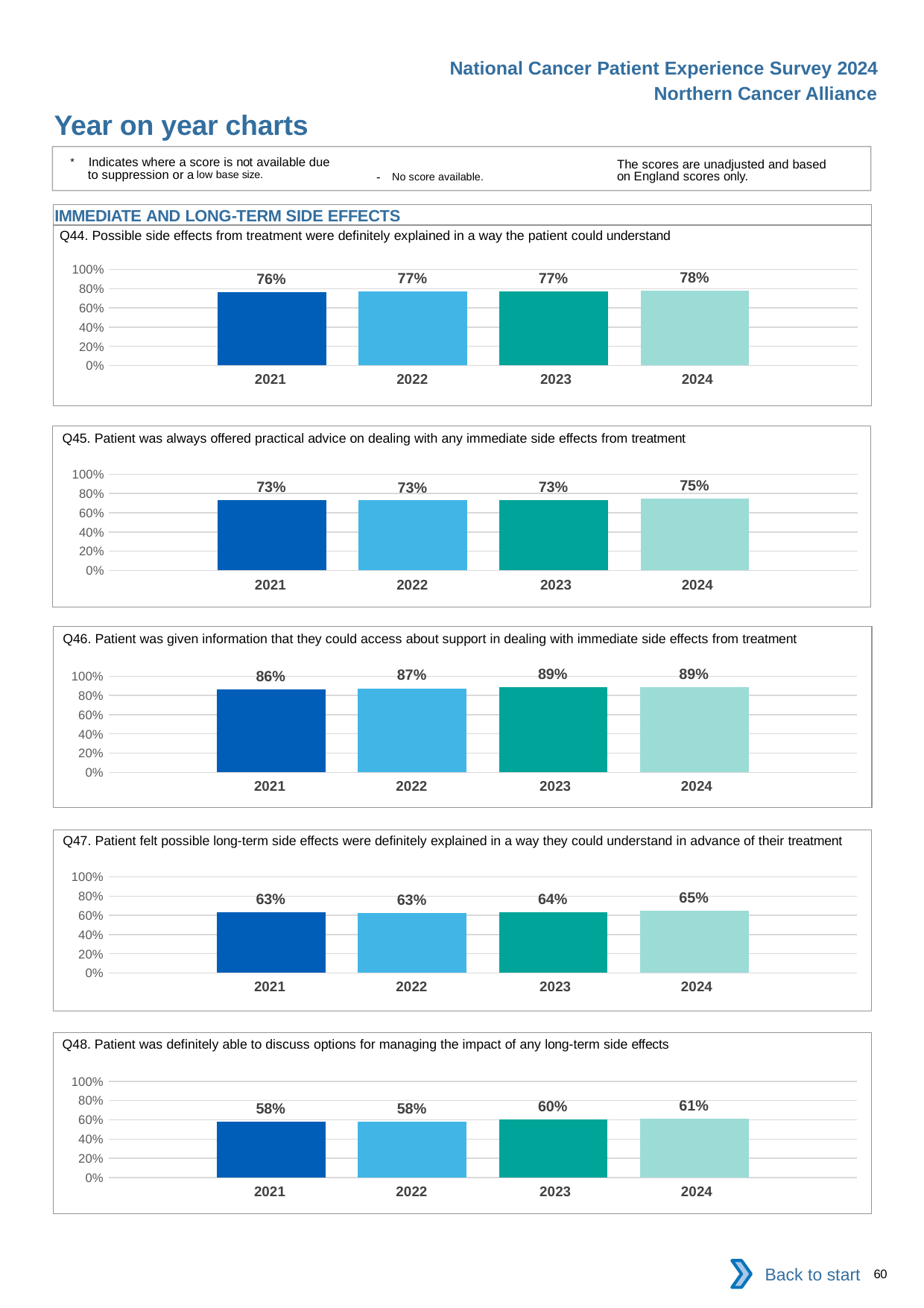
In the Q48 chart, do the values rise or fall from 2021 to 2024? rise In the Q44 chart, what is the value for 2024? 78% In the Q47 chart, what is the difference between the 2024 and 2021 values? 2% How many years are shown on the x axis of the Q44 chart? 4 In the Q48 chart, is the value for 2024 greater or less than 80%? less In the Q46 chart, what is the value for 2022? 87% In the Q48 chart, which is larger, the value for 2023 or the value for 2021? 2023 In the Q45 chart, what is the value for 2021? 73% In the Q46 chart, which year has the lowest value? 2021 How many charts are shown on the slide? 5 What kind of chart is the Q46 chart? bar chart In the Q45 chart, what is the difference between the 2024 and 2023 values? 2%